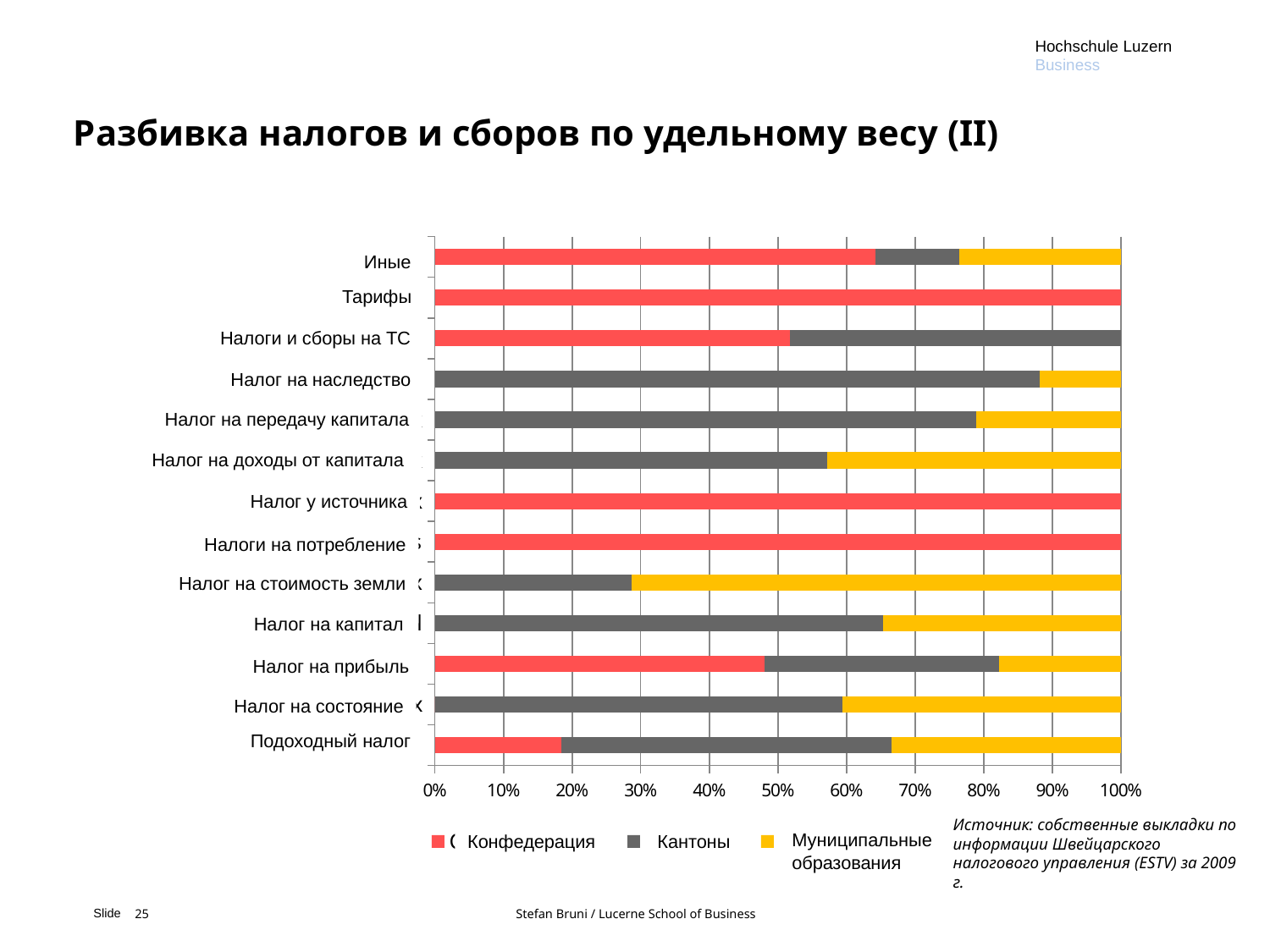
Which colour represents Кантоны in the chart? Grey What is the share of Конфедерация for Налог у источника? 100% What is the share of Конфедерация for Тарифы? 100% Is the Кантоны share for Налог на наследство greater or less than 80%? greater Is the Конфедерация share for Подоходный налог greater or less than 20%? less How many series does the chart legend list? 3 Which has a larger Конфедерация share: Налог на прибыль or Подоходный налог? Налог на прибыль Which has a larger Муниципальные образования share: Налог на стоимость земли or Налог на капитал? Налог на стоимость земли Is the Конфедерация share for Налог на прибыль greater or less than 50%? less How many tax categories are listed on the vertical axis of the chart? 13 What kind of chart is shown on the slide? Stacked bar chart